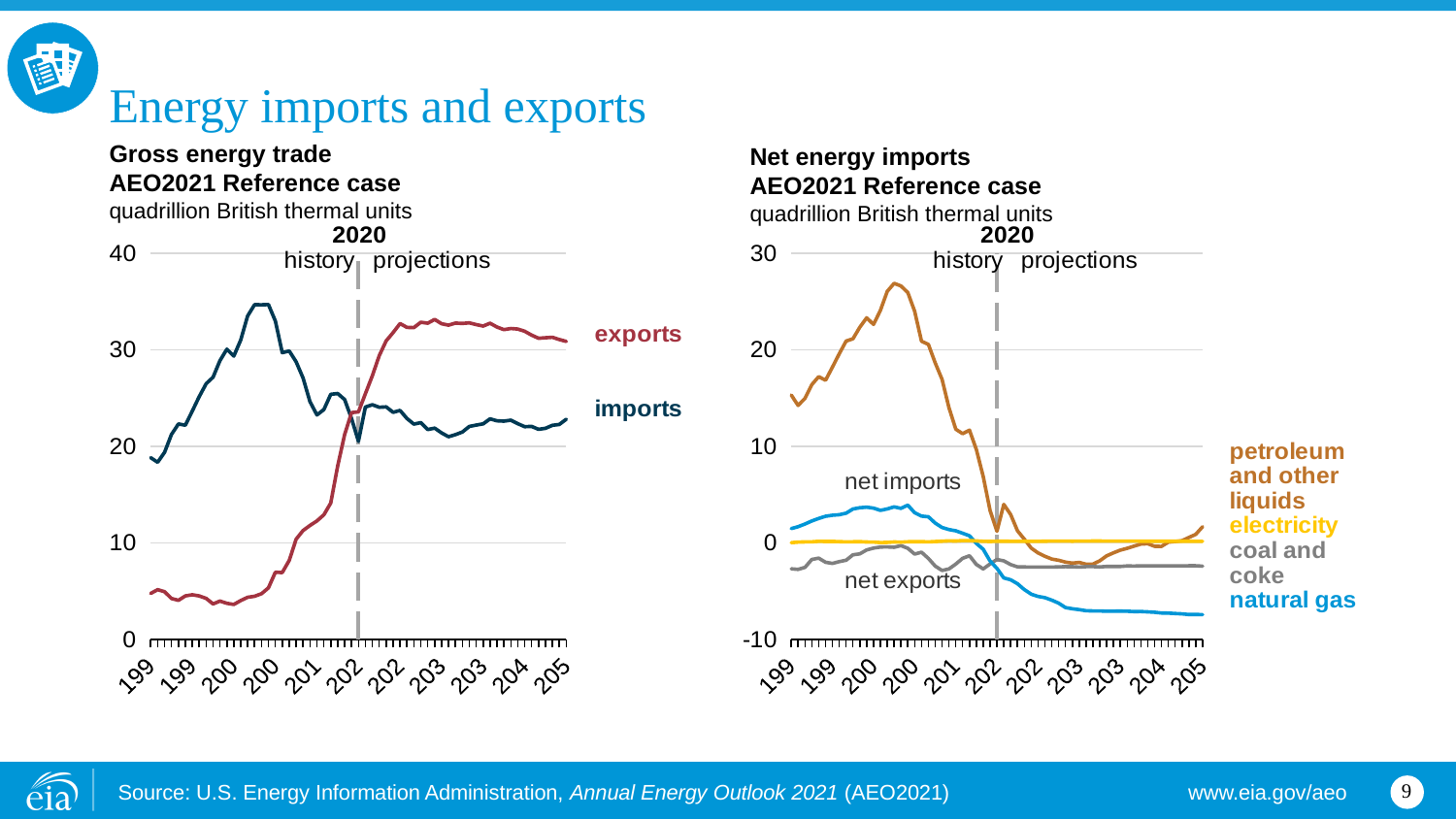
In the 'Net energy imports' chart, does the natural gas series rise or fall over the projection period? fall In the 'Net energy imports' chart, which series reaches the highest value? petroleum and other liquids In the 'Gross energy trade' chart, is the value for exports at the end of the projection period greater or less than 20? greater What year does the dashed vertical line mark on both charts? 2020 In the 'Gross energy trade' chart, is the value for exports at the start of the history period greater or less than 10? less In the 'Net energy imports' chart, which series is lowest at the end of the projection period? natural gas In the 'Net energy imports' chart, is the peak value for petroleum and other liquids greater or less than 20? greater How many series are labelled on the 'Net energy imports' chart on the right? 4 How many series are labelled on the 'Gross energy trade' chart on the left? 2 What kind of chart is the 'Gross energy trade' chart on the left? line chart In the 'Gross energy trade' chart, which series is higher at the end of the projection period, exports or imports? exports